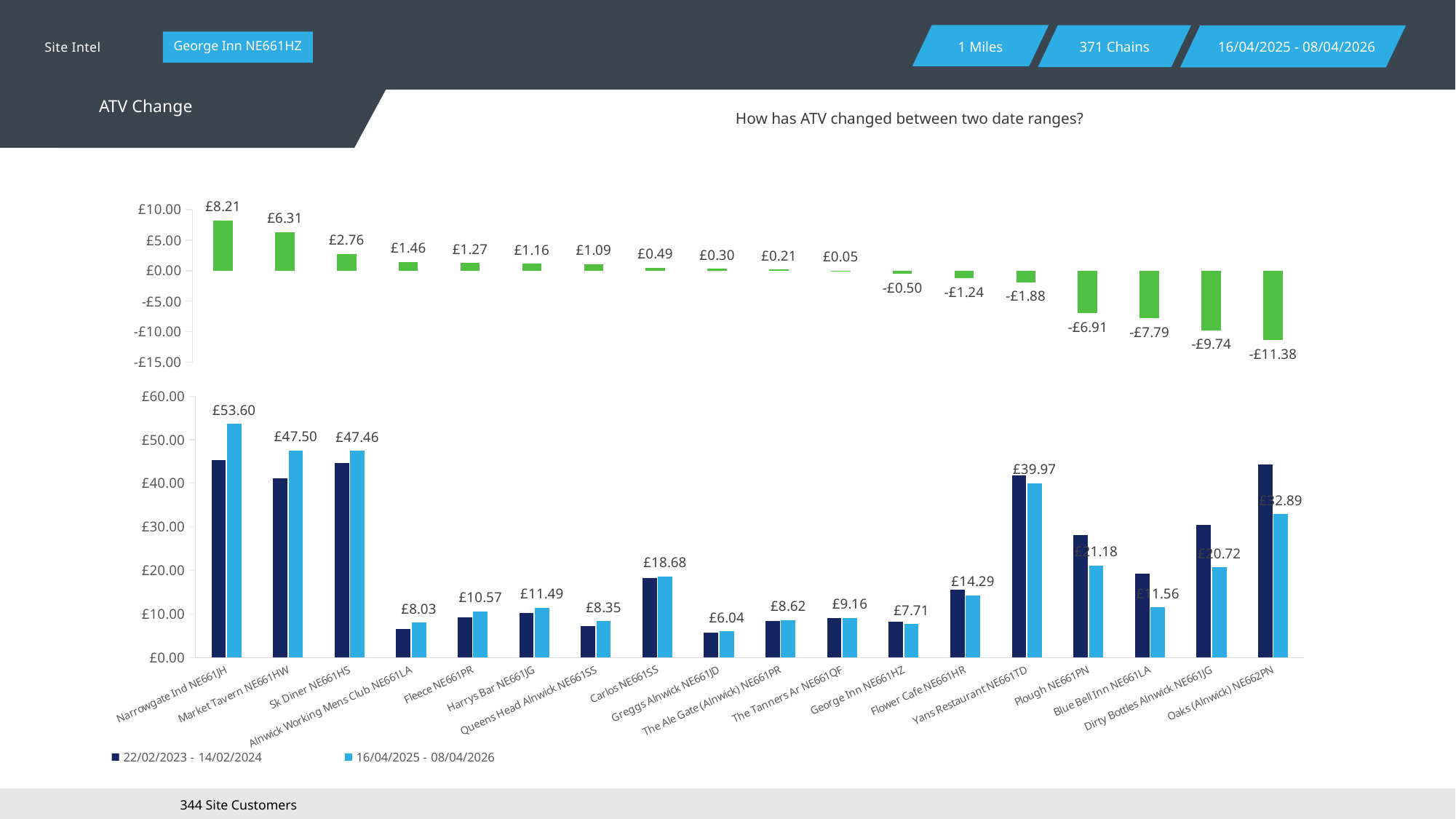
How many series does the legend of the bottom chart list? 2 On the top chart, what is the lowest value shown? -£11.38 What kind of chart is the bottom chart? bar chart On the bottom chart, what is the difference between the 16/04/2025 - 08/04/2026 values for Narrowgate Ind NE661JH and Market Tavern NE661HW? £6.10 On the bottom chart, what is the value for Greggs Alnwick NE661JD in the 16/04/2025 - 08/04/2026 series? £6.04 On the bottom chart, for Oaks (Alnwick) NE662PN, which series has the larger value? 22/02/2023 - 14/02/2024 On the bottom chart, what is the value for Carlos NE661SS in the 16/04/2025 - 08/04/2026 series? £18.68 On the top chart, what is the highest value shown? £8.21 On the bottom chart, is the 22/02/2023 - 14/02/2024 value for Oaks (Alnwick) NE662PN greater or less than £40.00? greater On the bottom chart, what is the value for Narrowgate Ind NE661JH in the 16/04/2025 - 08/04/2026 series? £53.60 How many categories are shown on the x axis of the bottom chart? 18 What colour are the bars for the 16/04/2025 - 08/04/2026 series on the bottom chart? light blue